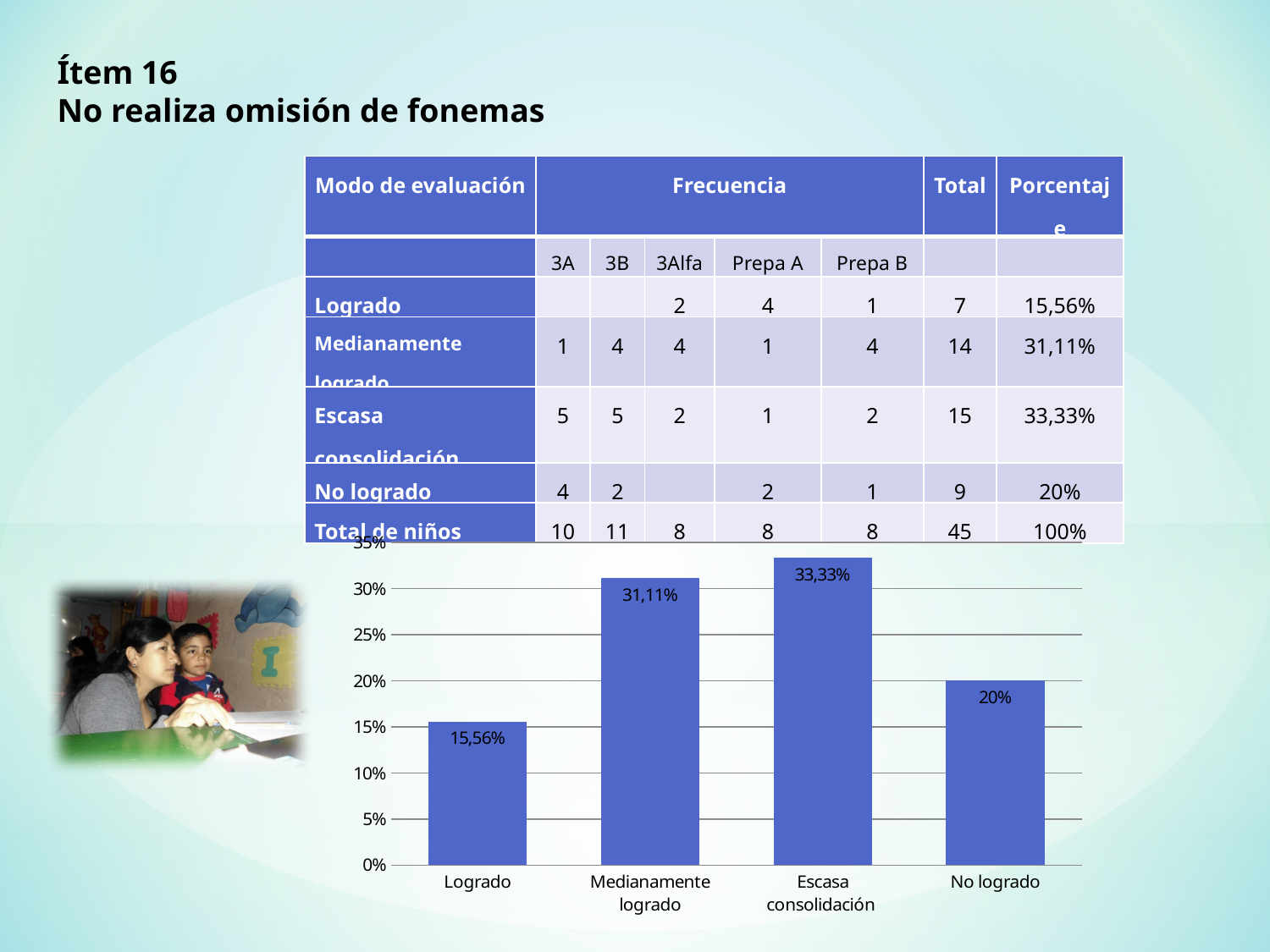
What is the value for Logrado? 15,56% What is the value for Medianamente logrado? 31,11% Which category has the lowest value? Logrado What is the difference between the values for Escasa consolidación and Medianamente logrado? 2,22% What is the value for Escasa consolidación? 33,33% What is the difference between the values for No logrado and Logrado? 4,44% Which is larger, the value for No logrado or the value for Logrado? No logrado Which category has the highest value? Escasa consolidación How many categories are shown on the x axis of the chart? 4 Is the value for Medianamente logrado greater or less than 25%? greater What kind of chart is shown on the slide? bar chart What is the value for No logrado? 20%